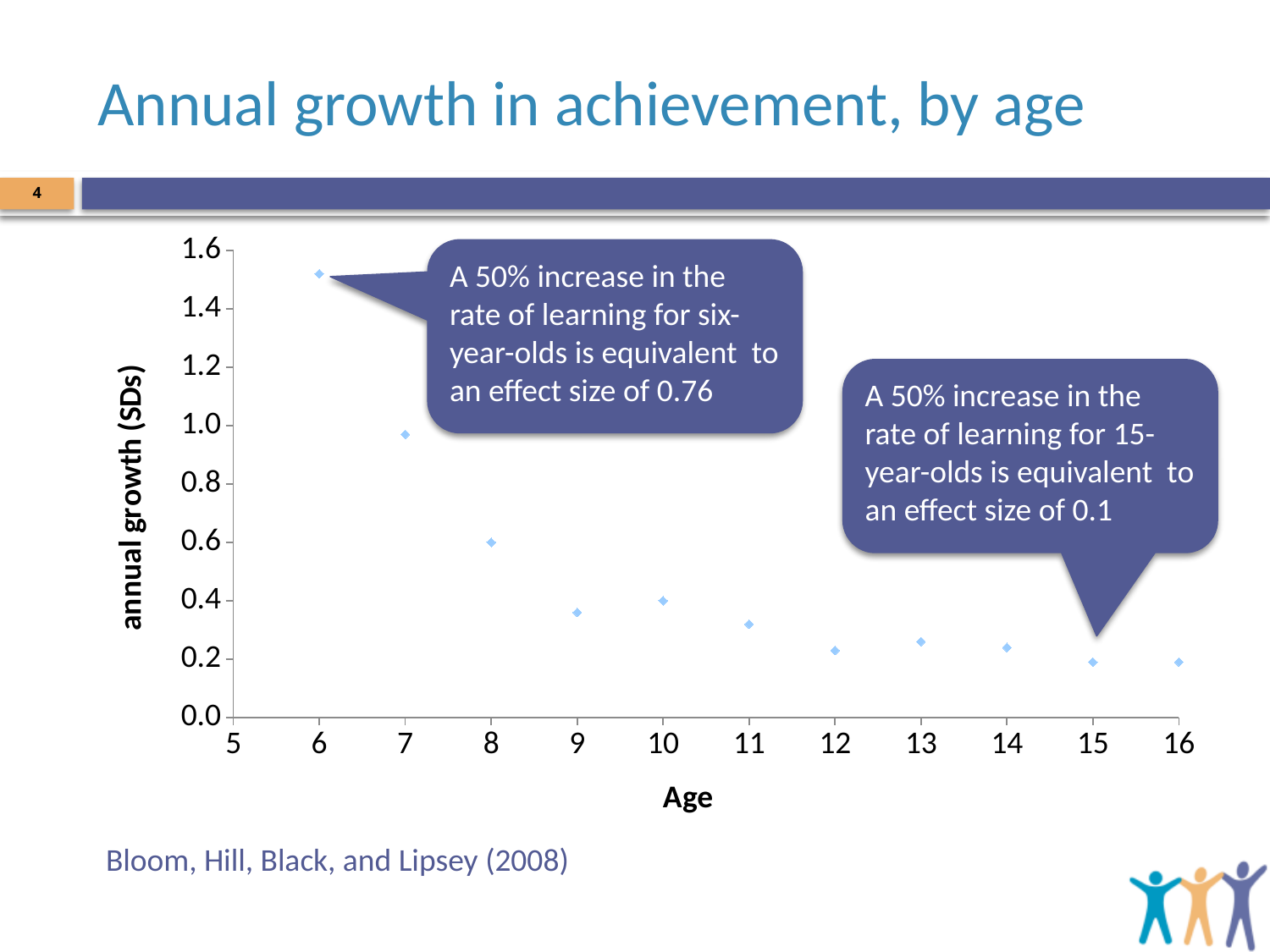
What kind of chart is shown on the slide? scatter chart At which age is annual growth in achievement highest? 6 Which age has a larger annual growth value, 6 or 7? 6 Is the annual growth value for age 8 greater or less than 0.4? greater Which age has a larger annual growth value, 8 or 12? 8 Is the annual growth value for age 6 greater or less than 1.4? greater How many data points are plotted in the chart? 11 Is the annual growth value for age 12 greater or less than 0.4? less What is the label of the y axis? annual growth (SDs) Do the values generally rise or fall as age increases along the x axis? fall What is the title of the chart? Annual growth in achievement, by age